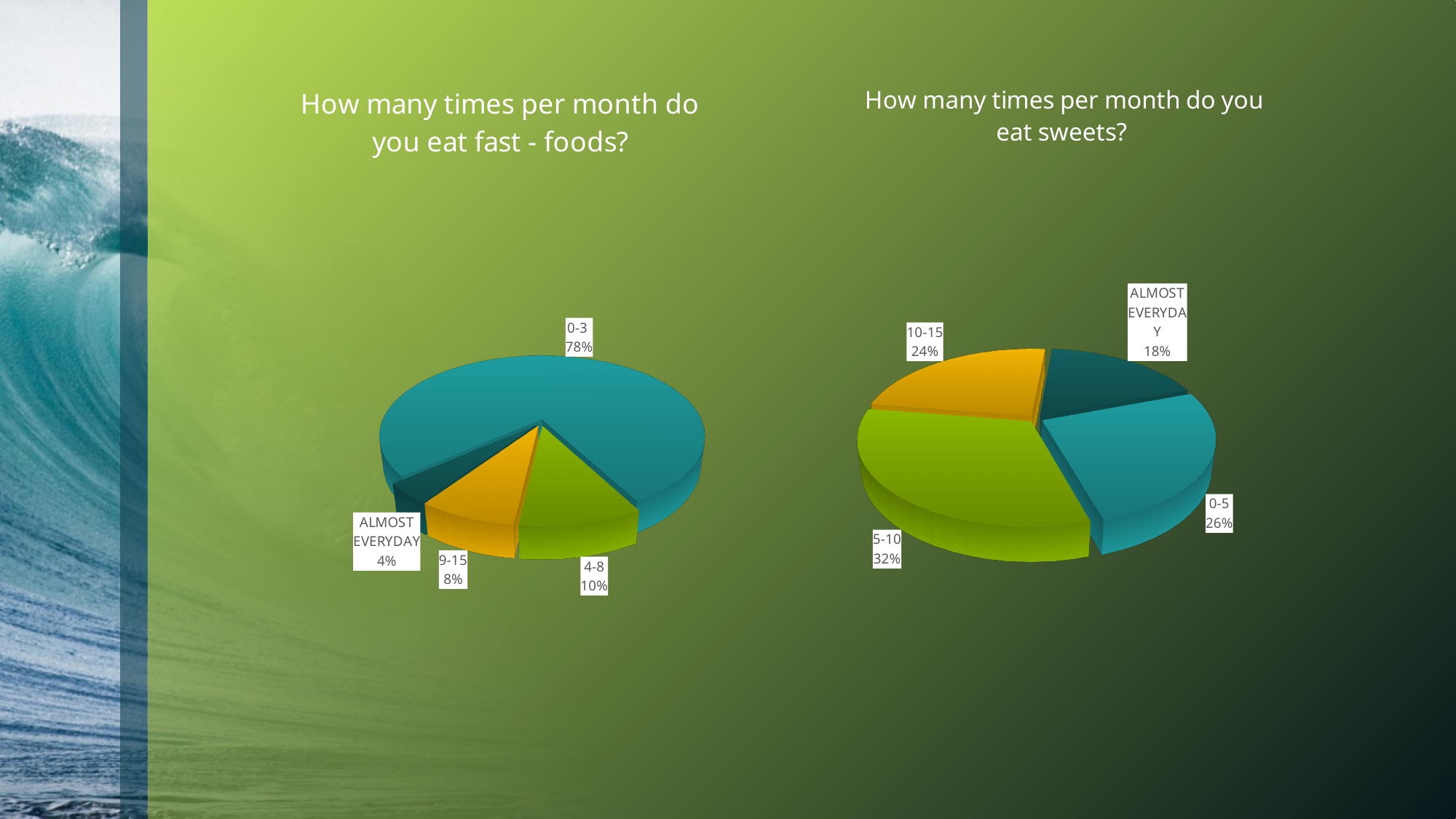
In the 'How many times per month do you eat sweets?' chart, which category has the largest slice? 5-10 In the 'How many times per month do you eat fast - foods?' chart, which category has the smallest slice? ALMOST EVERYDAY In the 'How many times per month do you eat fast - foods?' chart, which category has the largest slice? 0-3 In the 'How many times per month do you eat sweets?' chart, what is the value for 5-10? 32% In the 'How many times per month do you eat sweets?' chart, what is the value for ALMOST EVERYDAY? 18% In the 'How many times per month do you eat fast - foods?' chart, how many categories are shown? 4 In the 'How many times per month do you eat sweets?' chart, what is the difference between the 5-10 and ALMOST EVERYDAY slices? 14% In the 'How many times per month do you eat fast - foods?' chart, what is the difference between the 4-8 and 9-15 slices? 2% In the 'How many times per month do you eat fast - foods?' chart, what is the value for 4-8? 10% What type of chart is used on the right side of the slide? Pie chart In the 'How many times per month do you eat fast - foods?' chart, what share of the pie is the 0-3 slice? 78% In the 'How many times per month do you eat sweets?' chart, which is larger, 0-5 or 10-15? 0-5